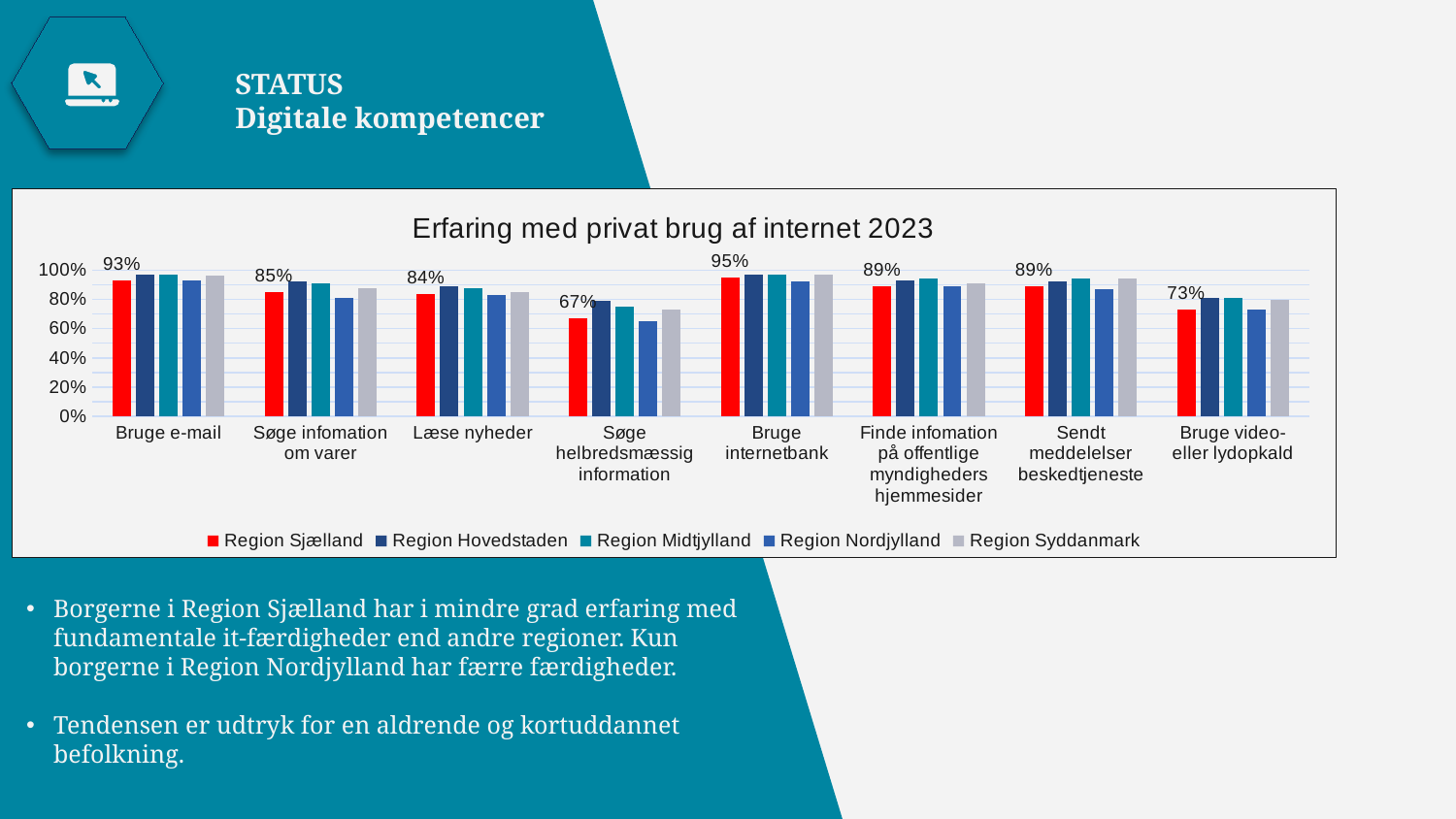
Is the value for Region Hovedstaden for "Bruge e-mail" greater or less than 80%? greater What is the value for Region Sjælland for "Bruge internetbank"? 95% How many series does the legend list? 5 For Region Sjælland, which is larger: "Bruge e-mail" or "Læse nyheder"? Bruge e-mail What is the value for Region Sjælland for "Bruge e-mail"? 93% What kind of chart is shown on the slide? Bar chart Among the labelled Region Sjælland values, which category is lowest? Søge helbredsmæssig information What is the value for Region Sjælland for "Søge helbredsmæssig information"? 67% What is the value for Region Sjælland for "Bruge video- eller lydopkald"? 73% Among the labelled Region Sjælland values, which category is highest? Bruge internetbank What is the difference between the Region Sjælland values for "Bruge internetbank" and "Søge helbredsmæssig information"? 28 percentage points How many categories are shown on the x axis? 8